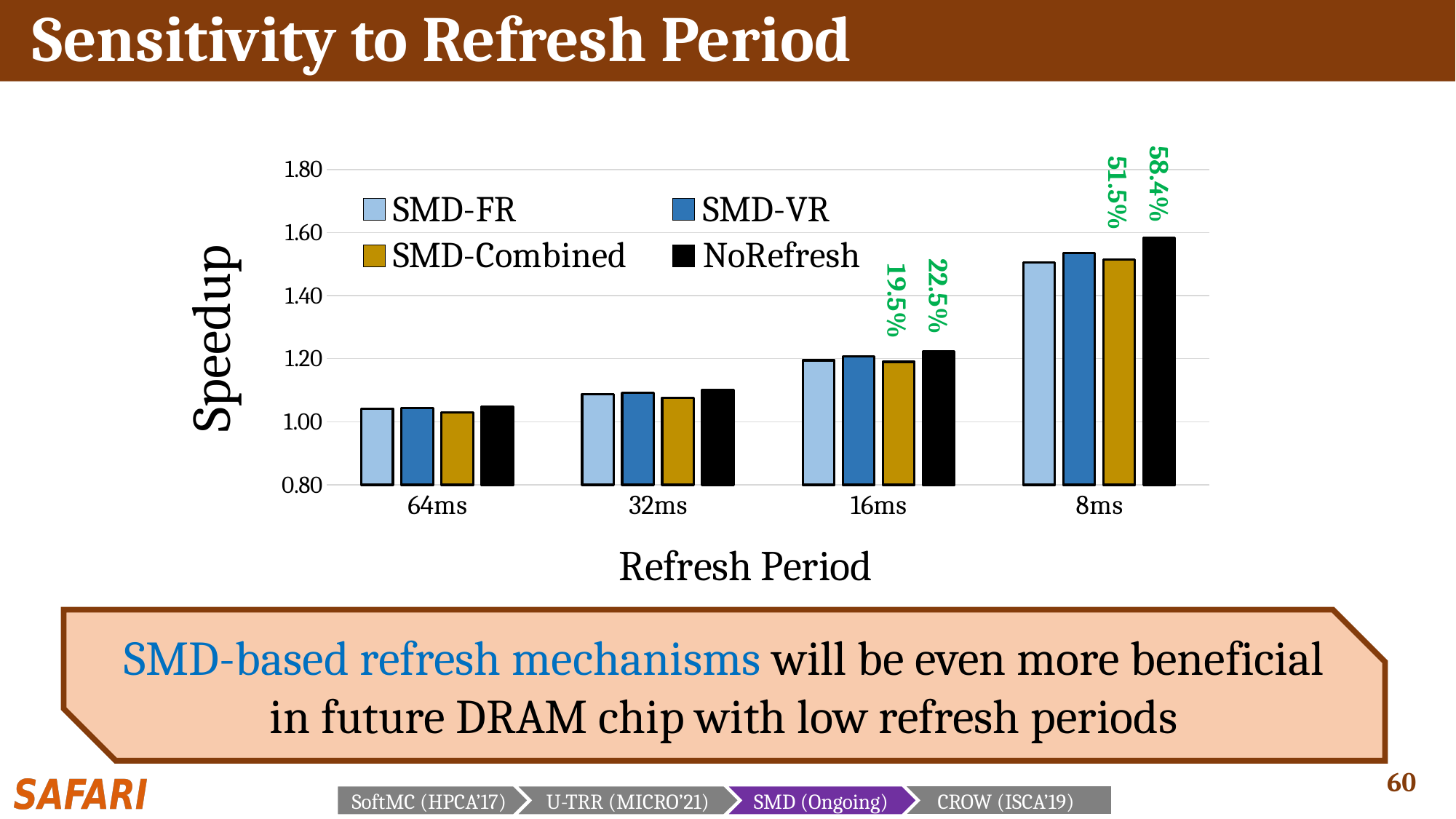
How many series does the legend list? 4 What is the label of the x axis? Refresh Period What percentage label is printed above the SMD-Combined bar at 8ms? 51.5% What is the label of the y axis? Speedup How many refresh period categories are shown on the x axis? 4 What percentage label is printed above the NoRefresh bar at 16ms? 22.5% For which refresh period is the NoRefresh speedup highest? 8ms For which refresh period is the SMD-FR speedup lowest? 64ms Is the NoRefresh speedup at 8ms greater or less than 1.40? greater What percentage label is printed above the NoRefresh bar at 8ms? 58.4% What percentage label is printed above the SMD-Combined bar at 16ms? 19.5% What kind of chart is shown on the slide? bar chart